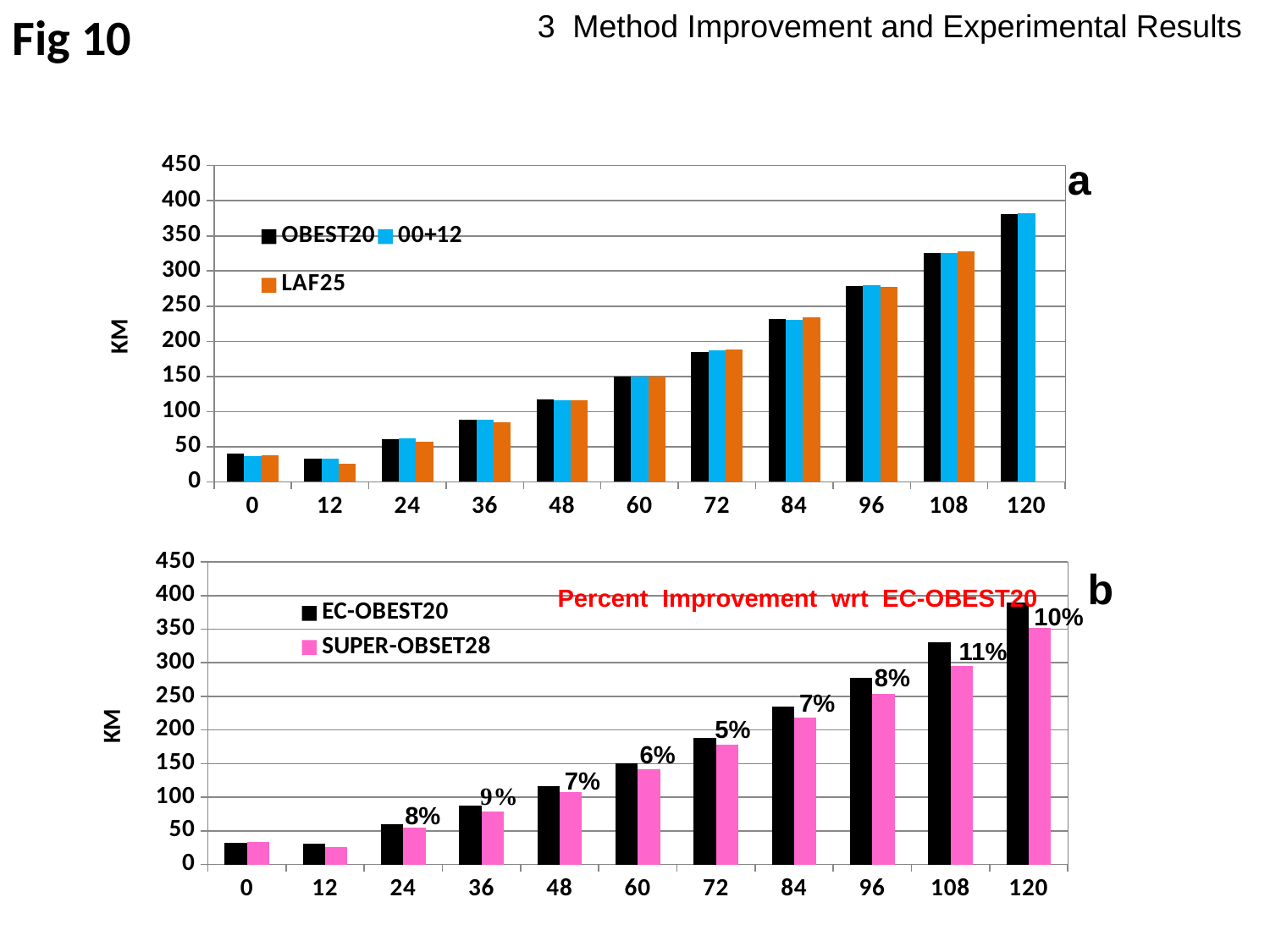
In chart a (the top chart), do the OBEST20 values generally rise or fall from 12 to 120 along the x axis? rise How many series does the legend of chart a (the top chart) list? 3 What kind of chart is chart a (the top chart)? bar chart How many categories are shown on the x axis of chart a (the top chart)? 11 In chart b (the bottom chart), at 120, which series has the larger value, EC-OBEST20 or SUPER-OBSET28? EC-OBEST20 How many series does the legend of chart b (the bottom chart) list? 2 In chart b (the bottom chart), at which x-axis category is the labelled percent improvement lowest? 72 In chart a (the top chart), which series has no bar at the 120 category? LAF25 In chart b (the bottom chart), what percent improvement is labelled at 108? 11% In chart a (the top chart), is the LAF25 value at 12 greater or less than 50? less In chart b (the bottom chart), at which x-axis category is the labelled percent improvement highest? 108 In chart a (the top chart), is the OBEST20 value at 120 greater or less than 350? greater